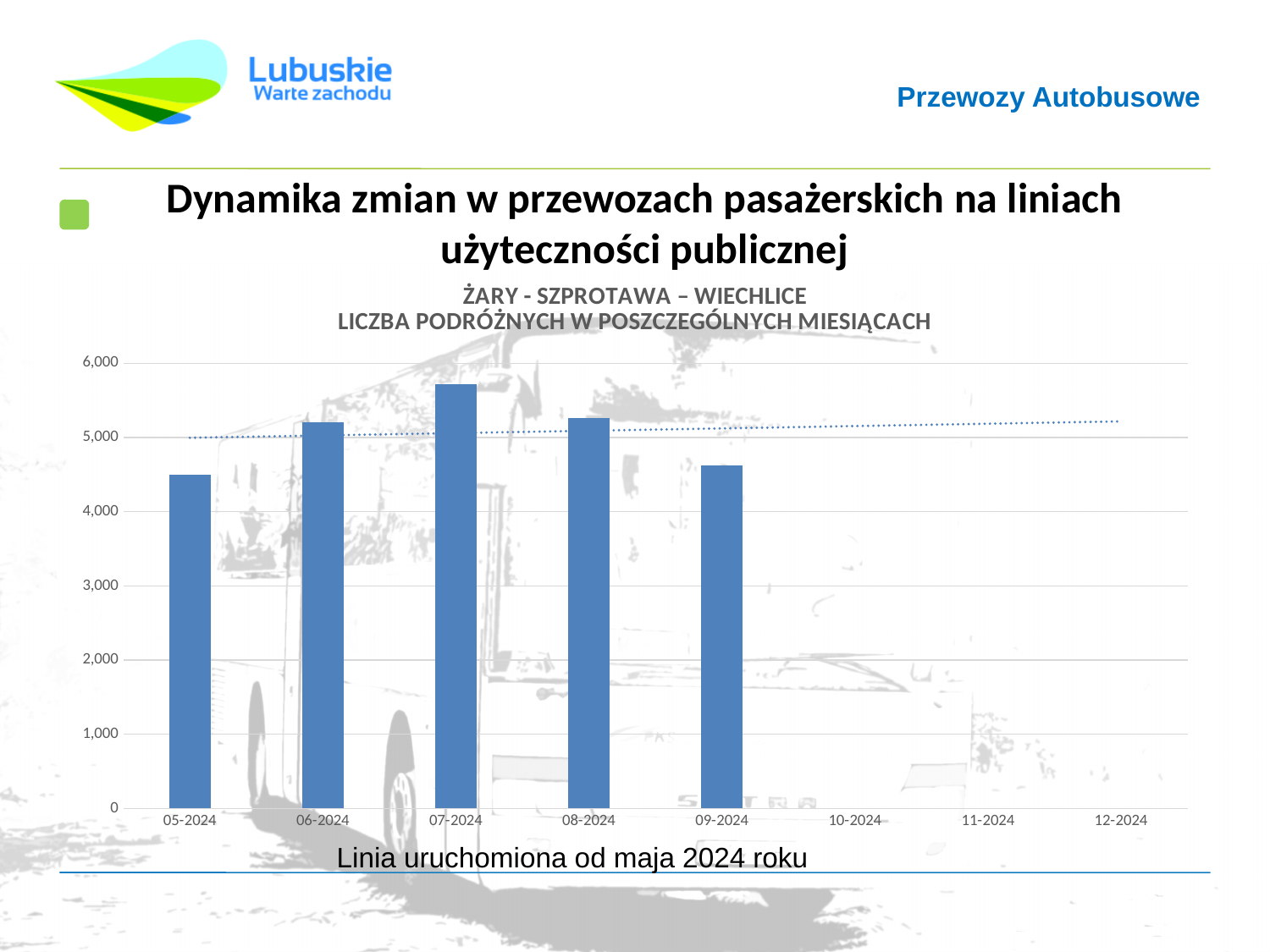
Is the value for 06-2024 greater or less than 5,000? greater What kind of chart is shown on the slide? bar chart Is the value for 08-2024 greater or less than 6,000? less How many months have a bar plotted on the chart? 5 How many month labels are shown on the x axis? 8 Is the value for 07-2024 greater or less than 5,000? greater Do the values rise or fall from 07-2024 to 09-2024? fall Which is larger, the value for 06-2024 or the value for 09-2024? 06-2024 Which month has the highest number of passengers? 07-2024 Which is larger, the value for 07-2024 or the value for 05-2024? 07-2024